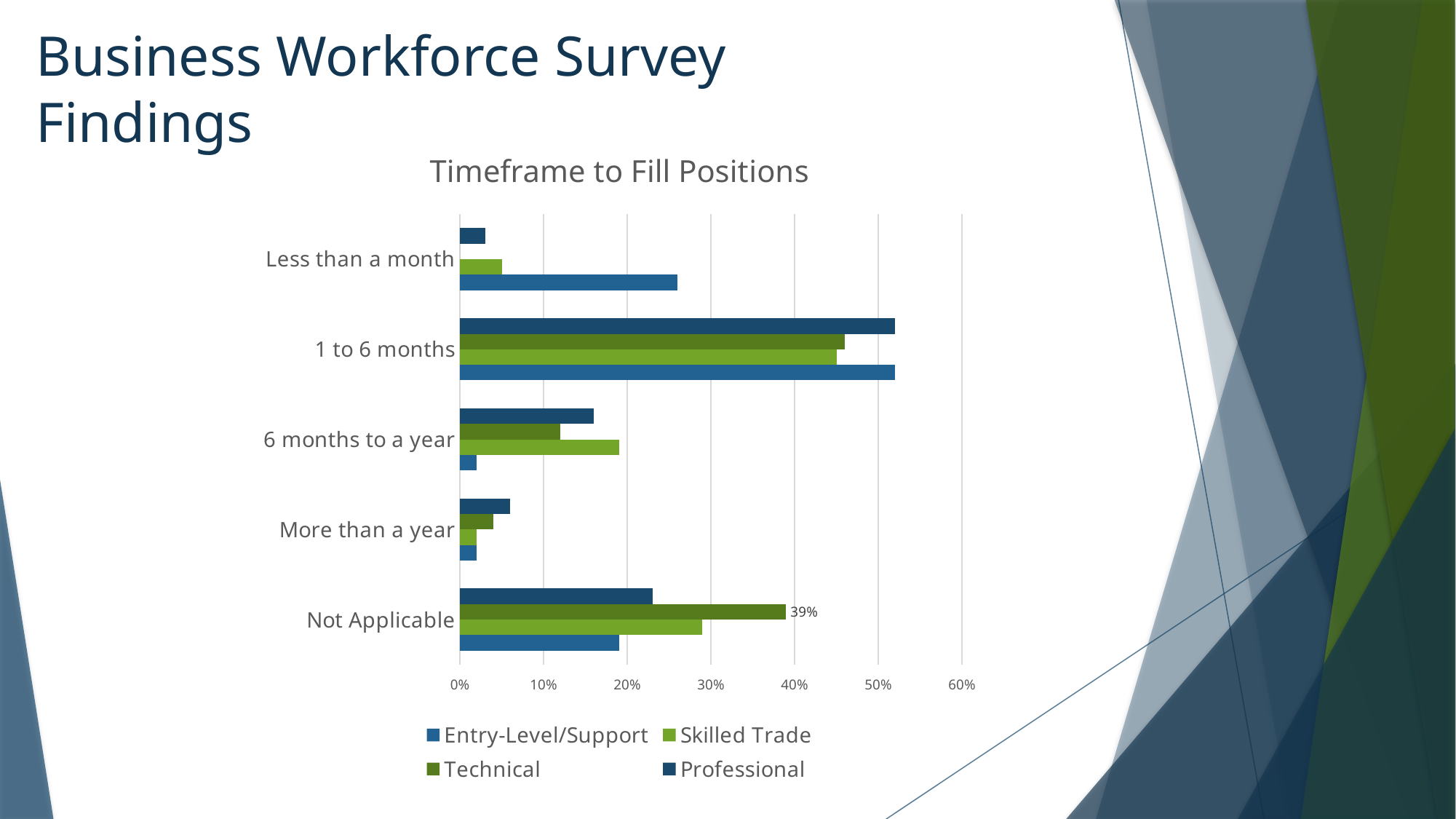
Which timeframe category has the highest Professional value? 1 to 6 months What kind of chart is shown on the slide? Bar chart Which timeframe category has the lowest Skilled Trade value? More than a year What is the Technical value for Not Applicable? 39% How many series does the legend list? 4 What is the title of the chart? Timeframe to Fill Positions Is the Professional value for 1 to 6 months greater or less than 40%? greater For Not Applicable, which is larger: the Technical value or the Entry-Level/Support value? Technical Is the Skilled Trade value for 6 months to a year greater or less than 10%? greater How many timeframe categories are shown on the chart? 5 Is the Entry-Level/Support value for Less than a month greater or less than 20%? greater For Less than a month, which is larger: the Entry-Level/Support value or the Professional value? Entry-Level/Support